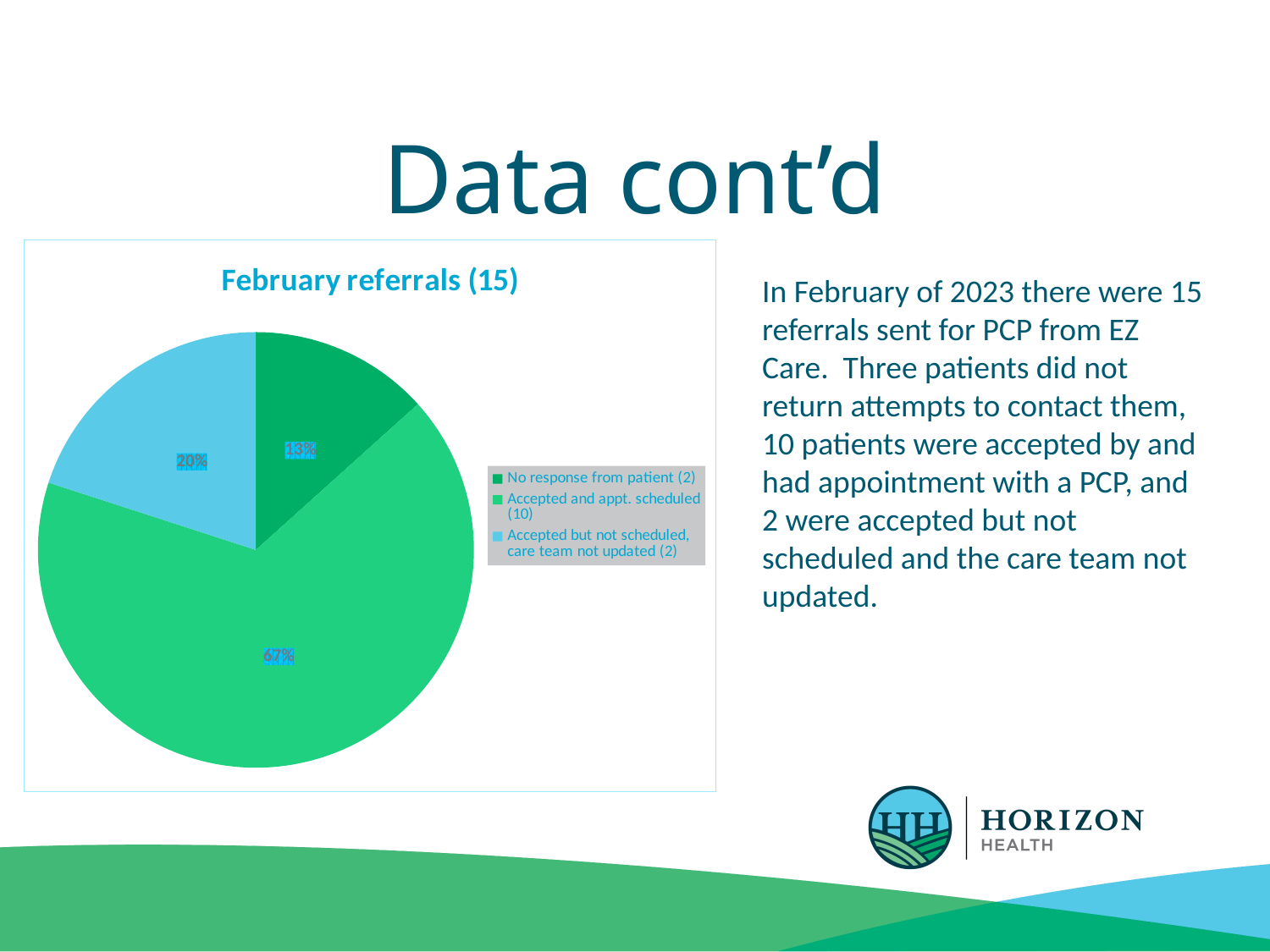
What percentage is shown for the 'Accepted but not scheduled, care team not updated (2)' slice? 20% Which category has the largest slice of the pie? Accepted and appt. scheduled (10) Is the 'Accepted and appt. scheduled (10)' slice larger or smaller than the 'Accepted but not scheduled, care team not updated (2)' slice? Larger What percentage is shown for the 'Accepted and appt. scheduled (10)' slice? 67% What kind of chart is shown on the slide? Pie chart How many entries does the legend list? 3 What is the difference in percentage points between the 67% slice and the 20% slice? 47 percentage points What is the title of the chart? February referrals (15) What percentage is shown for the 'No response from patient (2)' slice? 13% What colour is the 'Accepted but not scheduled, care team not updated (2)' slice? Light blue How many slices does the pie chart have? 3 Which category has the smallest slice of the pie? No response from patient (2)